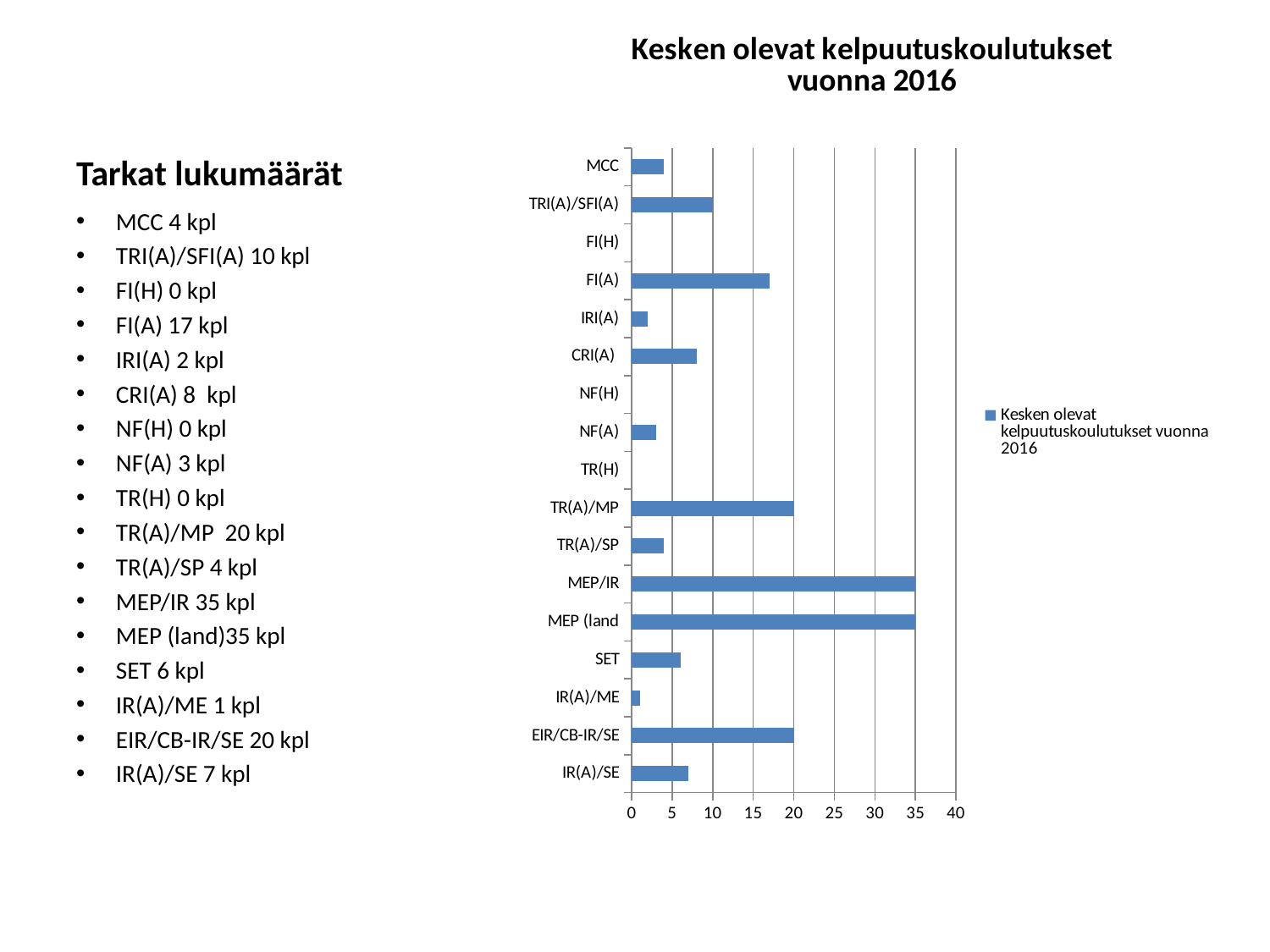
What type of chart is shown on the slide? bar chart How many series does the chart legend list? 1 How many categories are plotted in the chart? 17 Which two categories share the highest value in the chart? MEP/IR and MEP (land) What is the value for TR(A)/MP? 20 What is the value for SET? 6 Which is larger, the value for TR(A)/MP or the value for CRI(A)? TR(A)/MP What is the difference between the values for FI(A) and TRI(A)/SFI(A)? 7 Is the value for MEP/IR greater or less than 30? greater What is the value for FI(A)? 17 What is the value for IR(A)/SE? 7 What is the title of the chart? Kesken olevat kelpuutuskoulutukset vuonna 2016